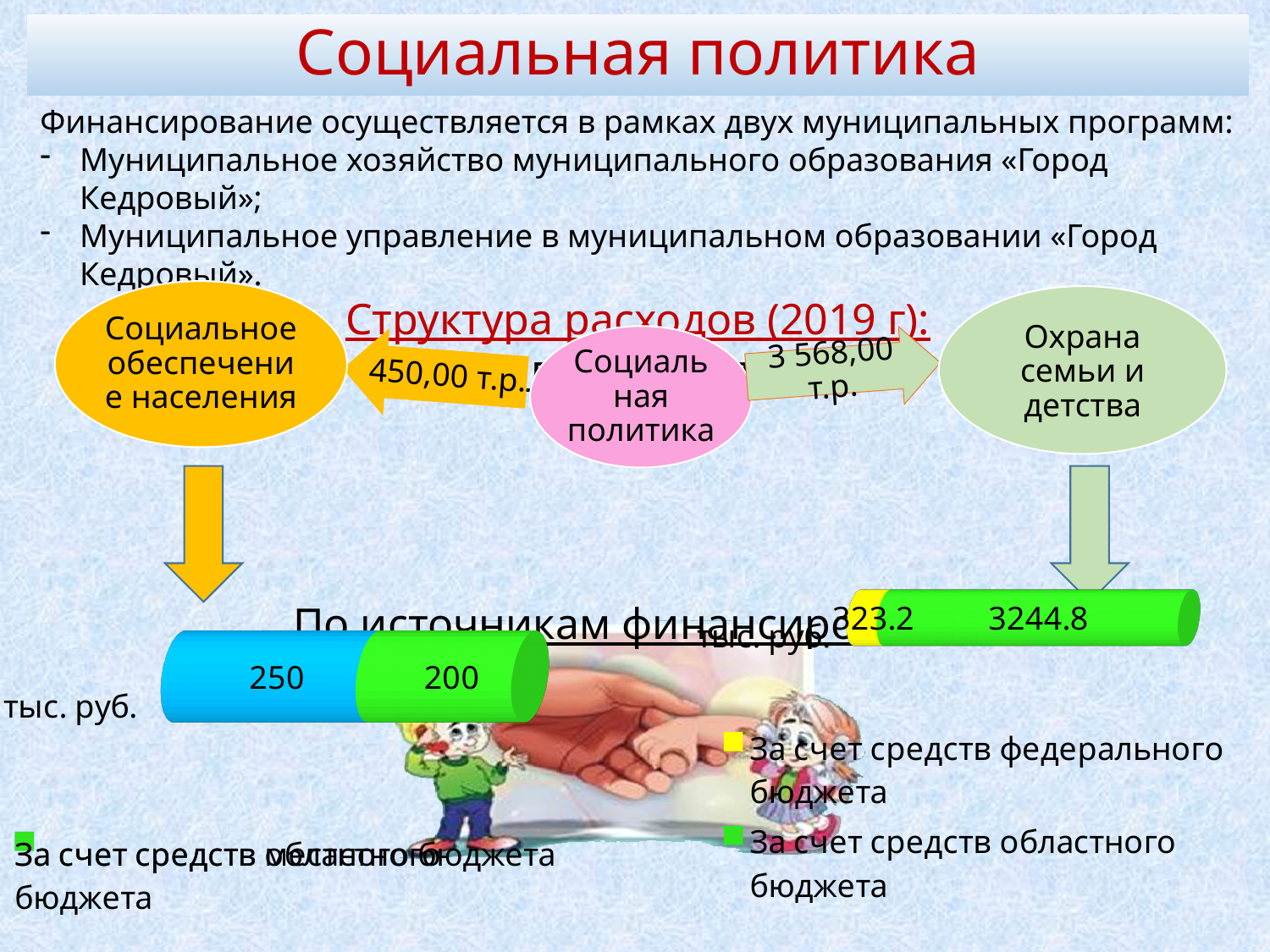
In the right bar chart (under «Охрана семьи и детства»), what is the difference between the green segment and the yellow segment? 2921.6 In what units are the values of the bar charts given, according to the axis label? тыс. руб. What kind of chart is used in the «По источникам финансирования» section of the slide? bar chart In the right bar chart (under «Охрана семьи и детства»), which funding source is larger: федерального бюджета or областного бюджета? За счет средств областного бюджета In the left bar chart (under «Социальное обеспечение населения»), what value is printed on the blue segment? 250 In the right bar chart (under «Охрана семьи и детства»), what is the total of the stacked bar? 3568 How many series does the legend of the right bar chart (under «Охрана семьи и детства») list? 2 In the left bar chart (under «Социальное обеспечение населения»), which segment is larger, the blue one or the green one? the blue one In the left bar chart (under «Социальное обеспечение населения»), what is the total of the stacked bar? 450 In the right bar chart (under «Охрана семьи и детства»), what value is printed on the yellow segment? 323.2 In the left bar chart (under «Социальное обеспечение населения»), what value is printed on the green segment? 200 In the right bar chart (under «Охрана семьи и детства»), what value is printed on the green segment? 3244.8